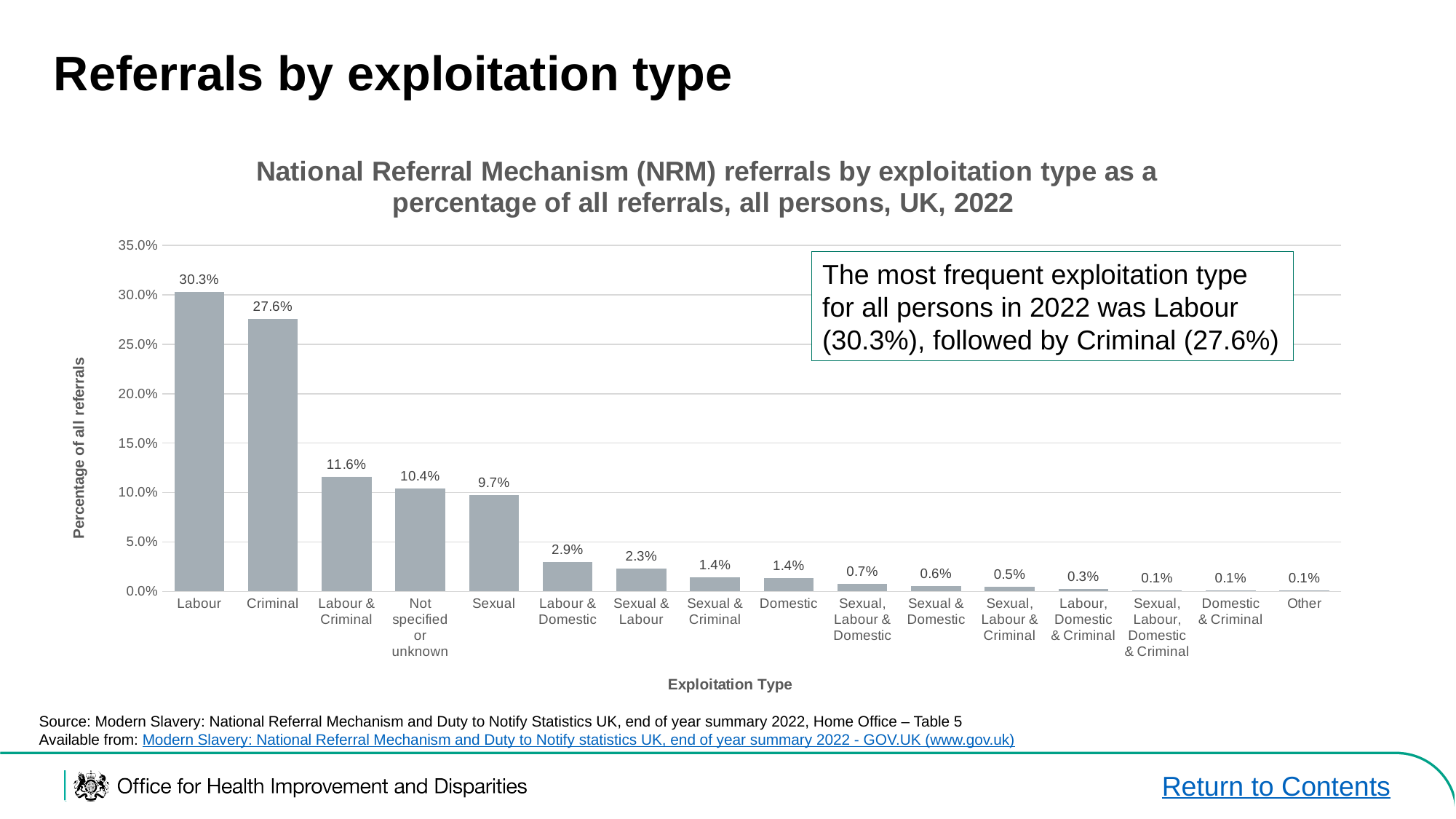
What type of chart is shown on the slide? Bar chart How many exploitation type categories are shown on the x axis? 16 Which is larger, the value for Sexual & Labour or the value for Labour & Domestic? Labour & Domestic What is the difference in percentage points between Labour (30.3%) and Criminal (27.6%)? 2.7 percentage points What is the value for Labour & Domestic exploitation? 2.9% What percentage of all referrals were for Labour exploitation? 30.3% What is the value shown for Criminal exploitation? 27.6% What is the value for Sexual exploitation? 9.7% What is the label of the y axis? Percentage of all referrals Which exploitation type has the highest percentage of referrals? Labour What percentage of referrals were 'Not specified or unknown'? 10.4% What is the difference between Labour & Criminal (11.6%) and Not specified or unknown (10.4%)? 1.2 percentage points